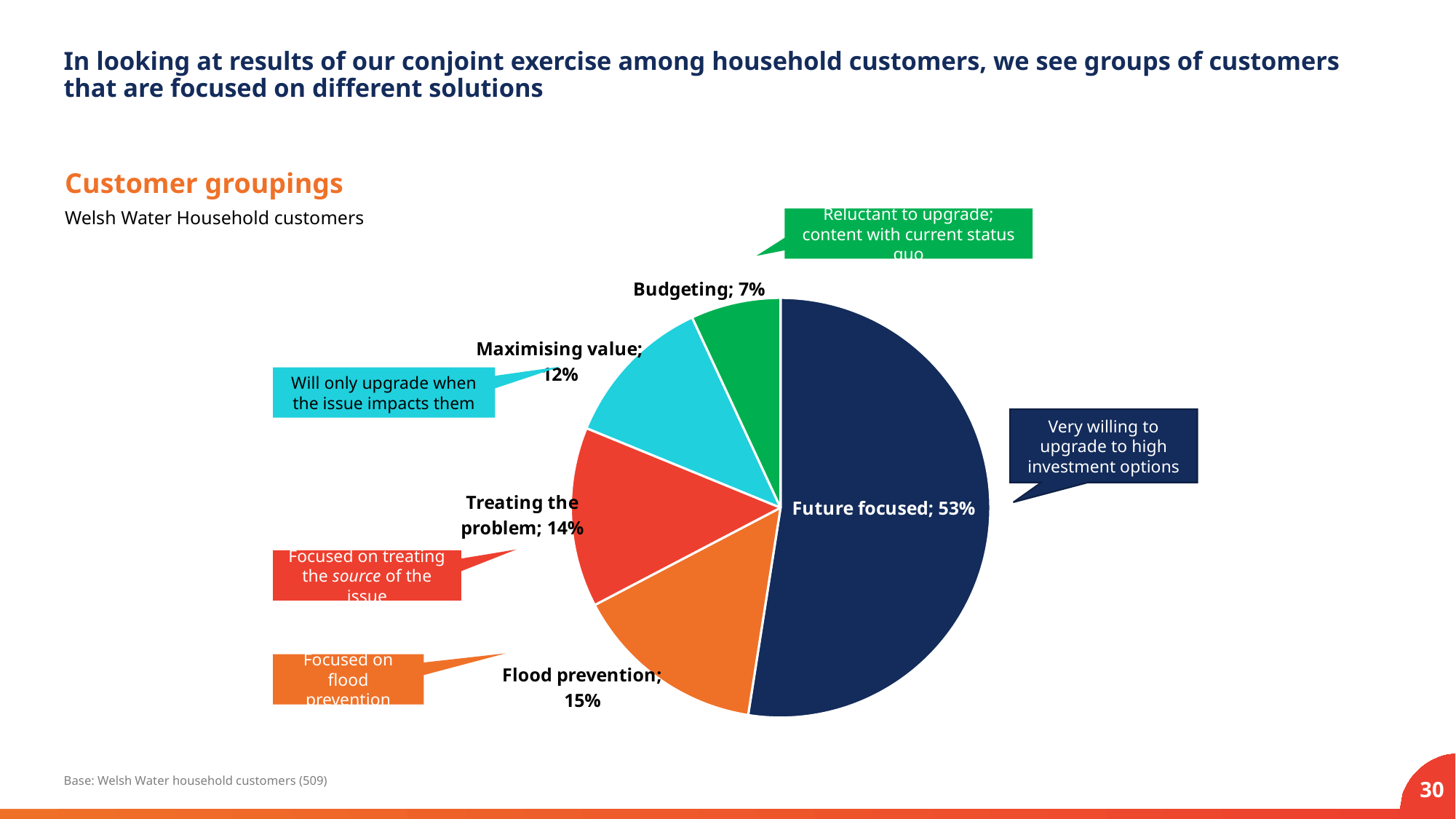
Which customer grouping has the largest share of the pie? Future focused Which group is larger: 'Treating the problem' or 'Maximising value'? Treating the problem How many customer groupings are shown in the pie chart? 5 What is the combined share of 'Treating the problem' and 'Flood prevention'? 29% Which customer grouping has the smallest share of the pie? Budgeting What share of Welsh Water household customers are in the 'Future focused' group? 53% What type of chart is used to show the customer groupings? Pie chart What is the value shown for the 'Budgeting' slice? 7% What percentage of customers fall into the 'Flood prevention' group? 15% What is the difference in percentage points between 'Future focused' and 'Flood prevention'? 38 What is the title of the chart? Customer groupings What percentage is shown for 'Maximising value'? 12%